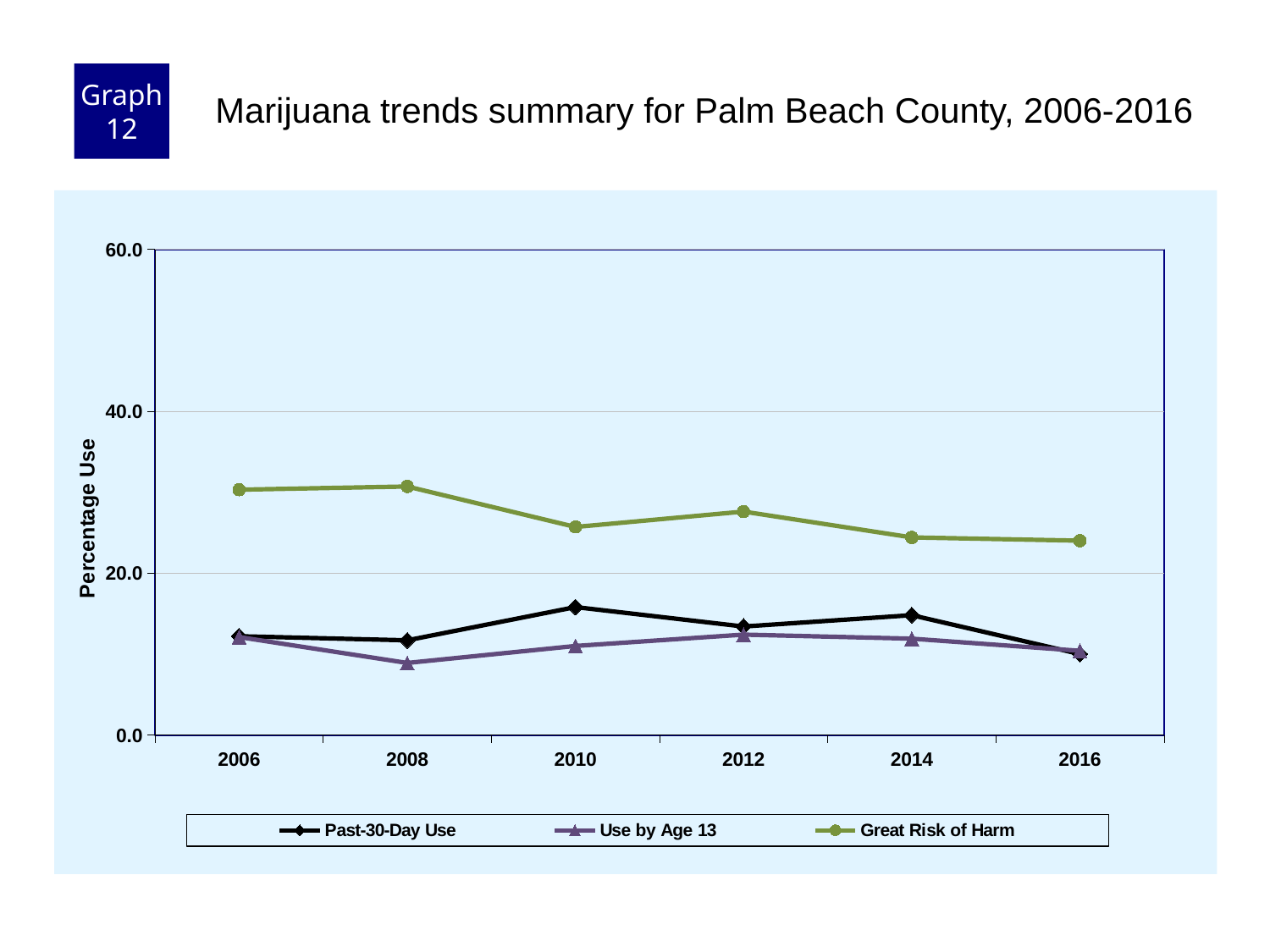
What is the label on the y axis? Percentage Use Is the value for Past-30-Day Use in 2010 greater or less than 20.0? less How many series does the legend list? 3 In which year is Past-30-Day Use at its lowest? 2016 Is the value for Great Risk of Harm in 2008 greater or less than 40.0? less In 2010, which is larger: Past-30-Day Use or Use by Age 13? Past-30-Day Use In which year is Use by Age 13 at its lowest? 2008 In 2010, which is larger: Great Risk of Harm or Past-30-Day Use? Great Risk of Harm Is the value for Great Risk of Harm in 2006 greater or less than 20.0? greater How many years are plotted along the x axis? 6 What kind of chart is shown on the slide? line chart Does Great Risk of Harm rise or fall overall from 2006 to 2016? fall